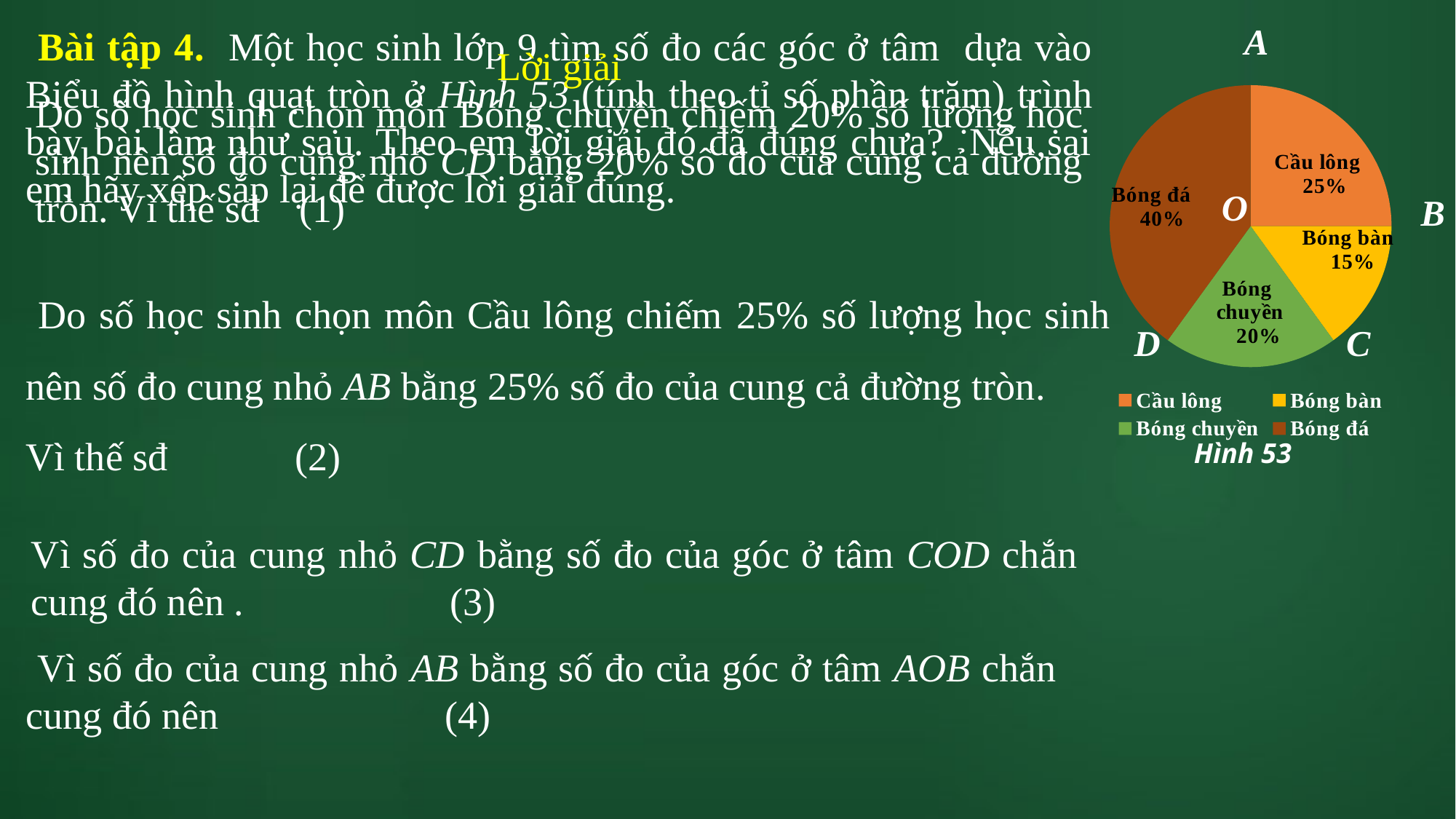
Which category has the smallest slice of the pie chart? Bóng bàn What percentage of the pie chart is Bóng đá? 40% What is the caption written below the pie chart's legend? Hình 53 What percentage of the pie chart is Bóng chuyền? 20% What kind of chart is shown on the slide? pie chart What is the difference in percentage points between Bóng đá and Cầu lông? 15 How many entries does the legend list? 4 What percentage of the pie chart is Cầu lông? 25% What percentage of the pie chart is Bóng bàn? 15% Which is larger, the slice for Bóng chuyền or the slice for Bóng bàn? Bóng chuyền How many slices does the pie chart have? 4 Which category has the largest slice of the pie chart? Bóng đá